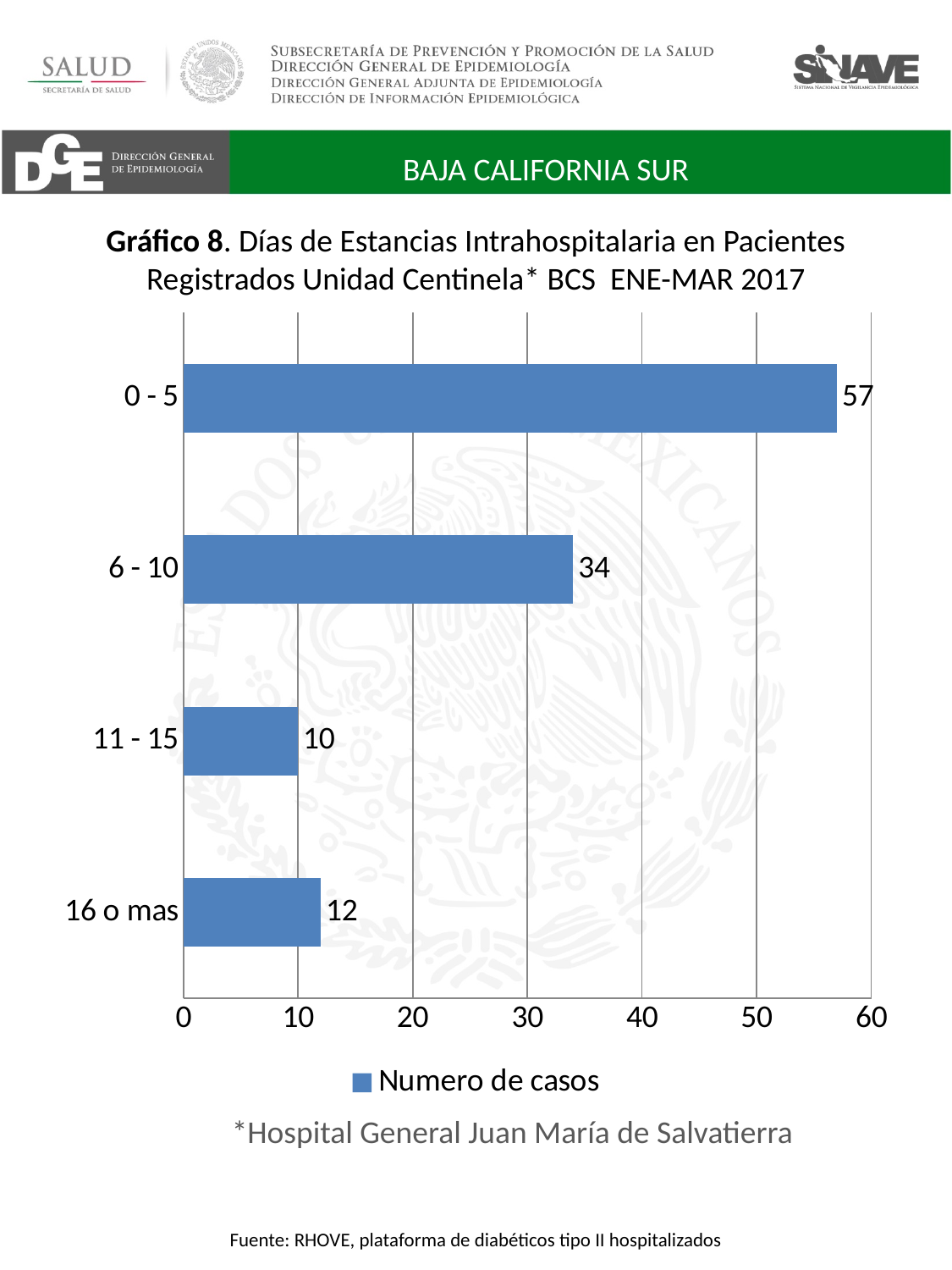
What is the number of cases for the 11 - 15 days category? 10 What is the number of cases for the 16 o mas category? 12 Which category has the highest number of cases? 0 - 5 What is the number of cases for the 0 - 5 days category? 57 What is the difference in number of cases between the 0 - 5 and 6 - 10 categories? 23 What kind of chart is shown on the slide? bar chart Which has more cases, 11 - 15 or 16 o mas? 16 o mas What is the number of cases for the 6 - 10 days category? 34 Which category has the lowest number of cases? 11 - 15 Is the value for 6 - 10 greater or less than 30? greater What series name does the legend show? Numero de casos How many categories are shown in the chart? 4